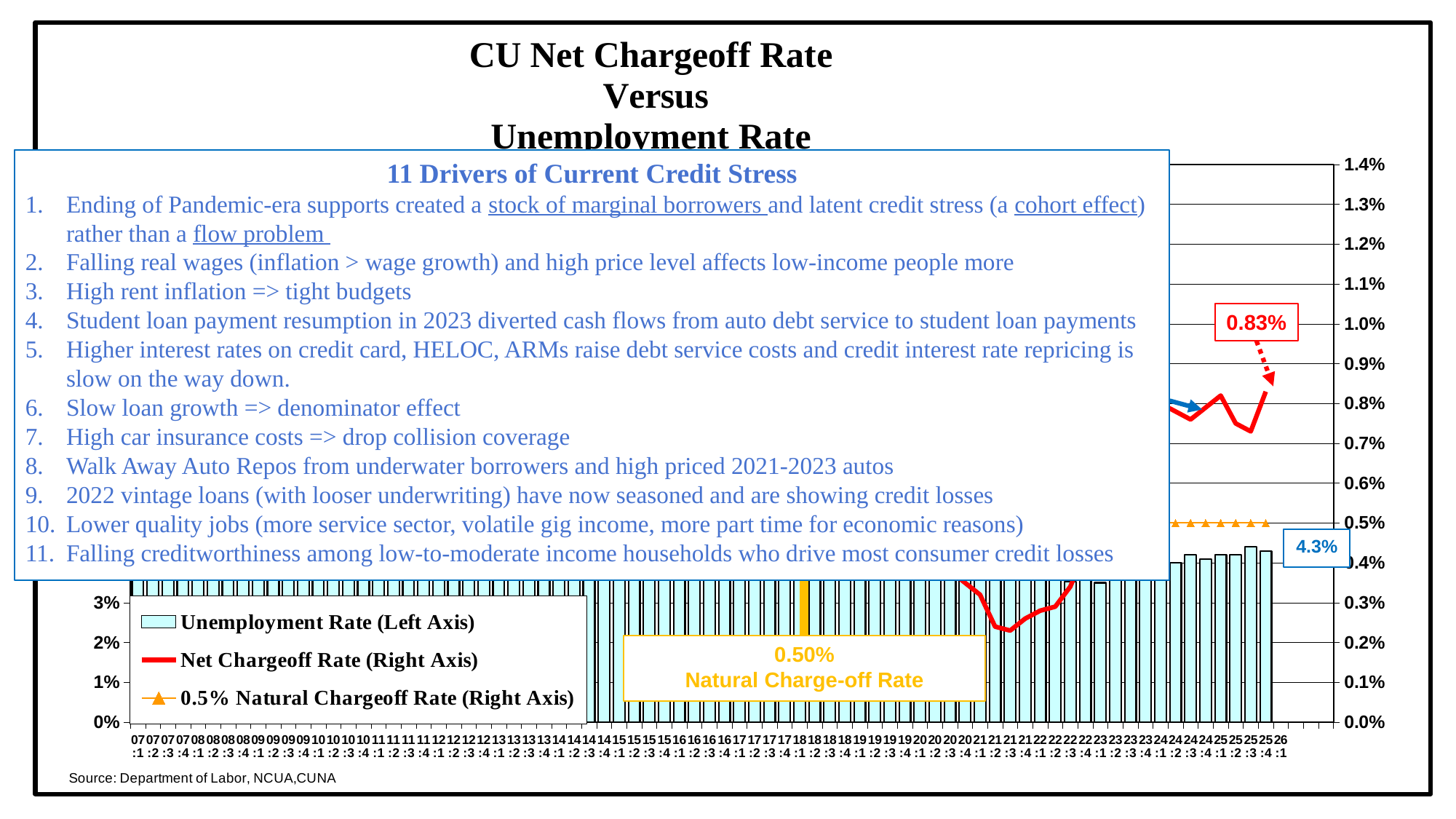
On which axis is the Unemployment Rate plotted, according to the legend? Left Axis What is the highest tick value shown on the right-hand axis? 1.4% What value is labelled for the projected Net Chargeoff Rate at the right end of the chart? 0.83% How many series does the chart's legend list? 3 Is the most recent Unemployment Rate bar greater or less than 3% on the left axis? greater What is the Natural Charge-off Rate shown on the chart? 0.50% What kind of chart is this? Combined bar and line chart What is the title of the chart? CU Net Chargeoff Rate Versus Unemployment Rate Is the most recent Net Chargeoff Rate value greater or less than 0.5% on the right axis? greater Is the labelled projected Net Chargeoff Rate (0.83%) greater or less than the 0.50% Natural Charge-off Rate? greater What is the difference between the labelled projected Net Chargeoff Rate of 0.83% and the 0.50% Natural Charge-off Rate? 0.33% What value is labelled for the Unemployment Rate at the right end of the chart? 4.3%